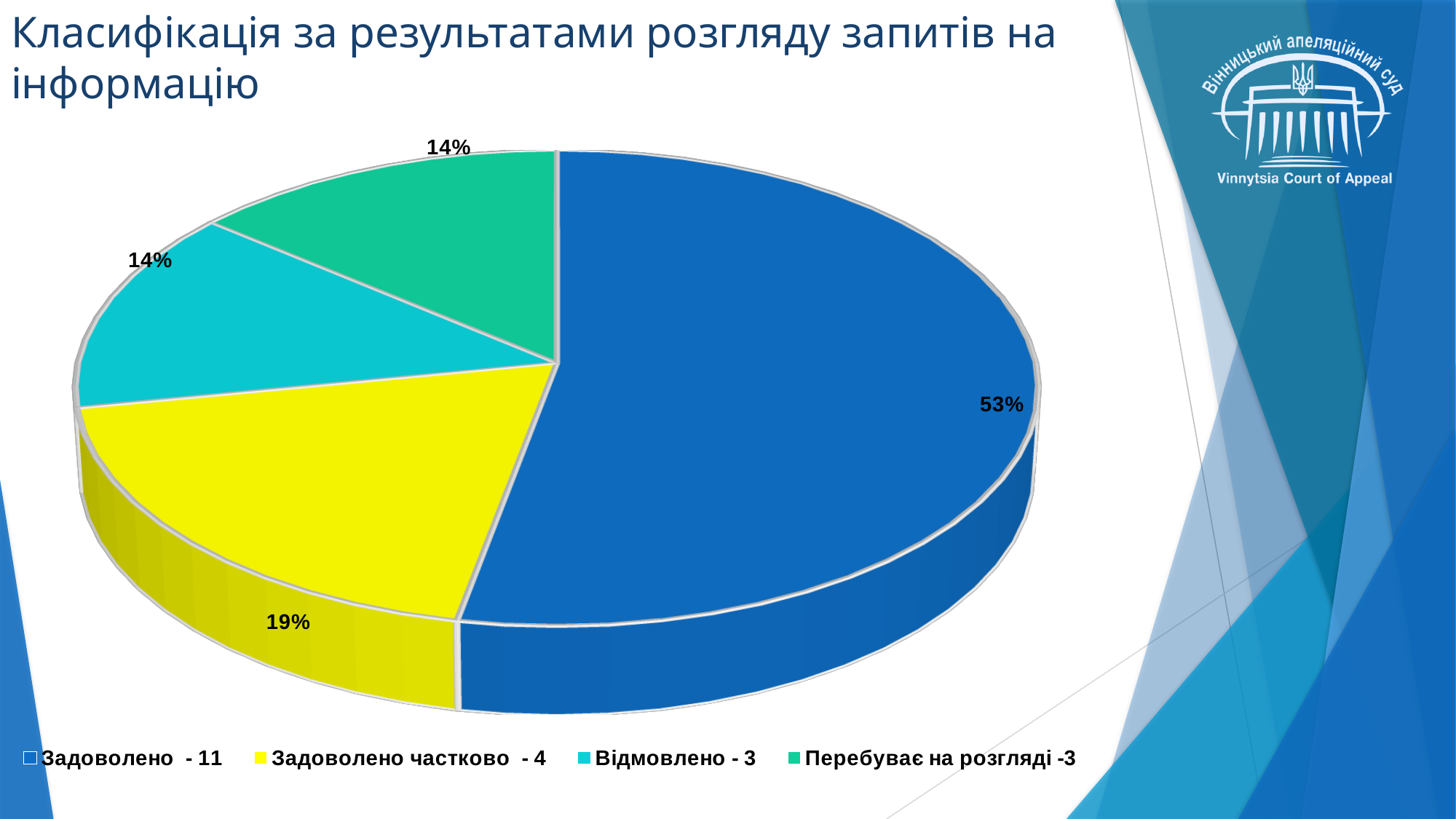
What share of the pie does the "Задоволено частково" slice represent? 19% What colour is the "Задоволено частково" slice? yellow What is the difference in percentage points between the "Задоволено" slice and the "Задоволено частково" slice? 34% According to the legend, how many requests fall under "Задоволено"? 11 What kind of chart is shown on the slide? pie chart Which category has the largest slice of the pie? Задоволено What percentage is shown for the "Відмовлено" slice? 14% What is the title of the slide? Класифікація за результатами розгляду запитів на інформацію How many slices does the pie chart have? 4 Which slice is larger: "Задоволено частково" or "Відмовлено"? Задоволено частково What share of the pie does the "Задоволено" slice represent? 53% What percentage is shown for the "Перебуває на розгляді" slice? 14%